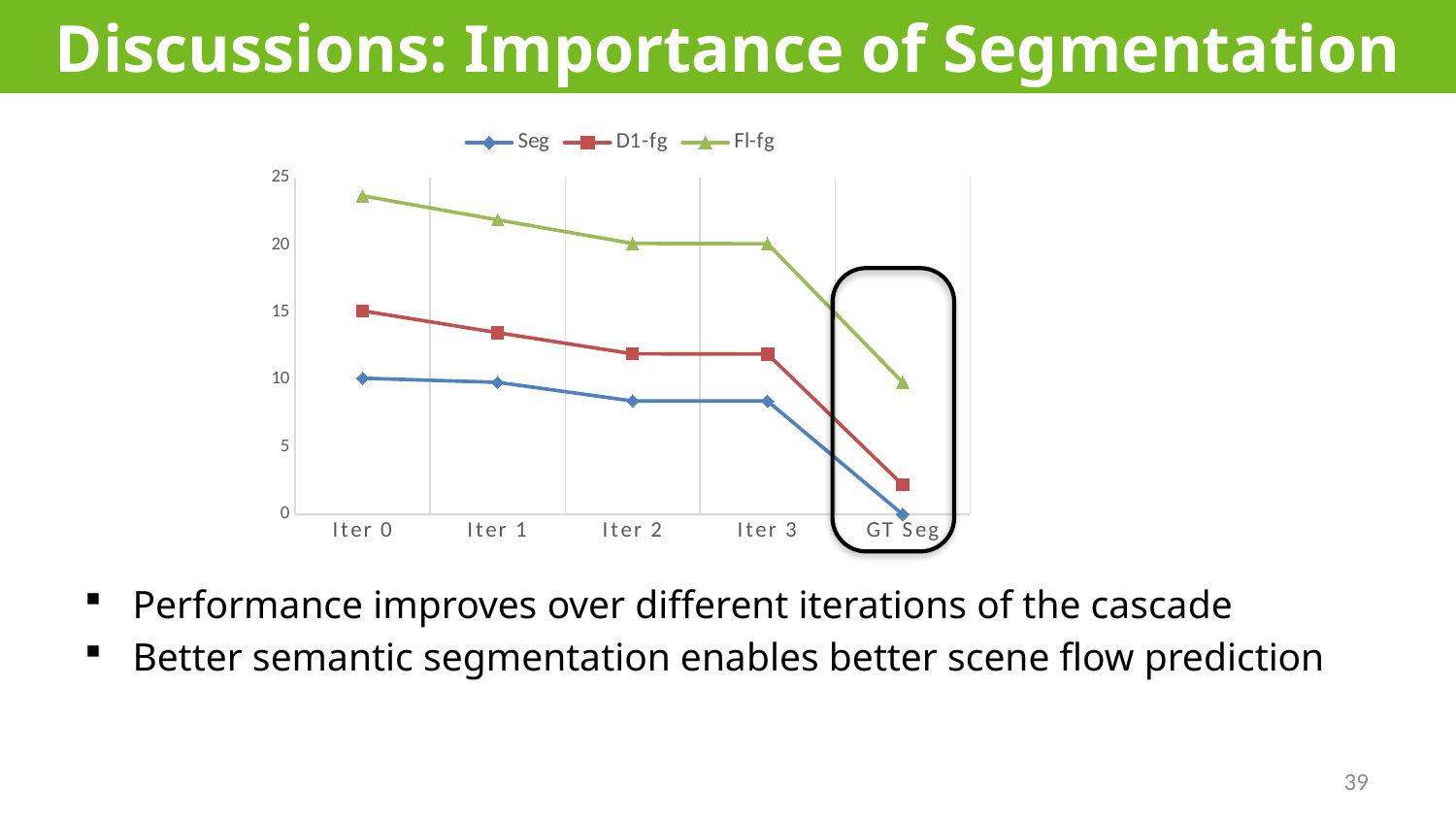
How many series does the legend list? 3 Which x-axis category is highlighted with a black outline on the chart? GT Seg Which is larger at Iter 1, the value for D1-fg or the value for Seg? D1-fg Is the value for D1-fg at Iter 0 greater or less than 10? greater Which series has the highest value at Iter 0? Fl-fg Is the value for D1-fg at GT Seg greater or less than 5? less Is the value for Seg at Iter 2 greater or less than 10? less Do the values for Fl-fg rise or fall from Iter 0 to GT Seg? fall Which series has the lowest value at Iter 3? Seg How many categories are shown on the x axis? 5 What kind of chart is shown on the slide? line chart